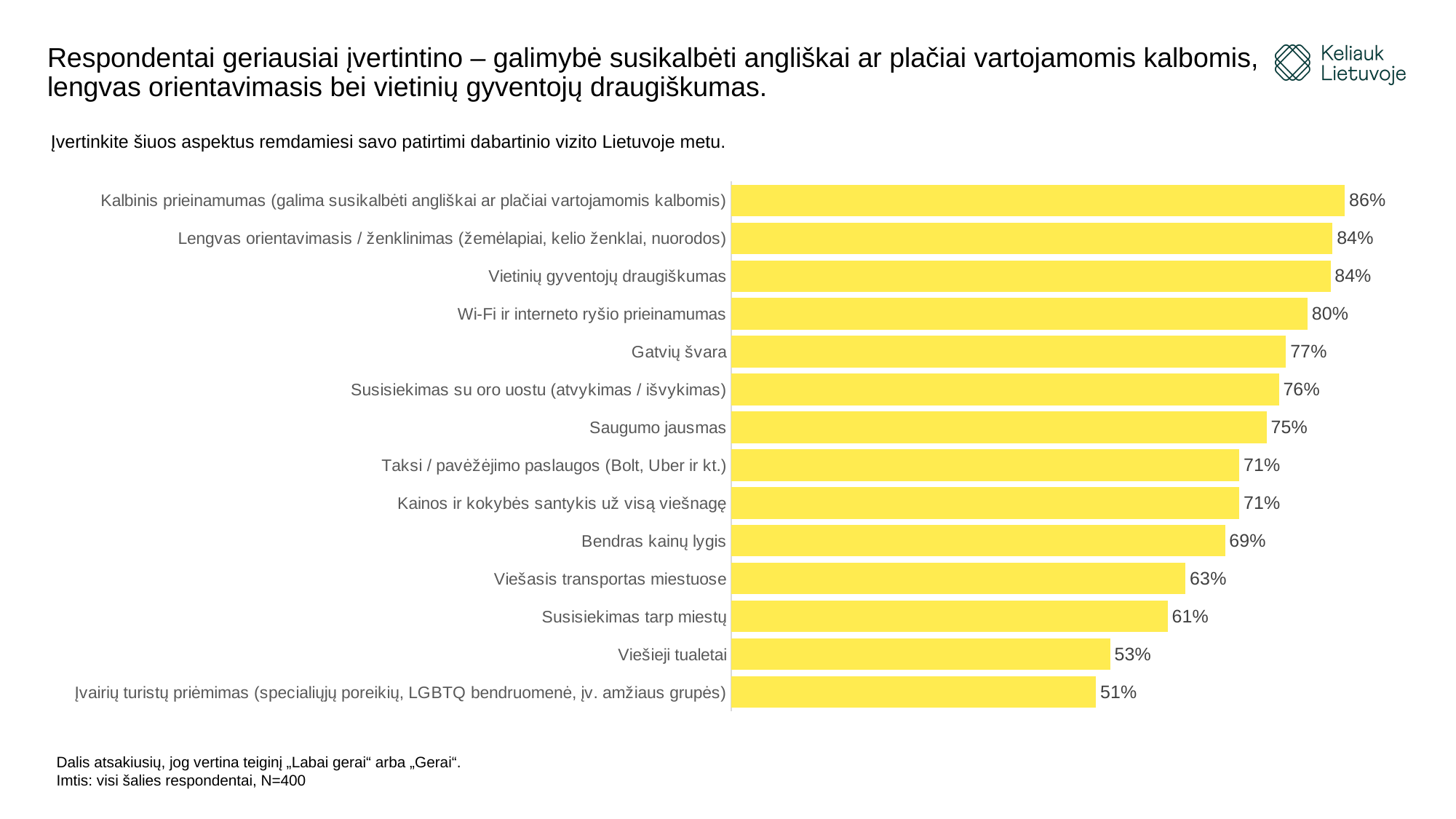
What is the value for "Wi-Fi ir interneto ryšio prieinamumas"? 80% What is the value for "Susisiekimas su oro uostu (atvykimas / išvykimas)"? 76% What is the value for "Viešieji tualetai"? 53% What is the difference between the highest and lowest values in the chart? 35% Which category has the highest value? Kalbinis prieinamumas (galima susikalbėti angliškai ar plačiai vartojamomis kalbomis) What is the value for "Gatvių švara"? 77% How many categories are shown in the chart? 14 Which category has the lowest value? Įvairių turistų priėmimas (specialiųjų poreikių, LGBTQ bendruomenė, įv. amžiaus grupės) Which is larger: the value for "Viešasis transportas miestuose" or the value for "Bendras kainų lygis"? Bendras kainų lygis What colour are the bars in the chart? Yellow What is the difference between the values for "Saugumo jausmas" and "Susisiekimas tarp miestų"? 14% What kind of chart is shown on the slide? Bar chart